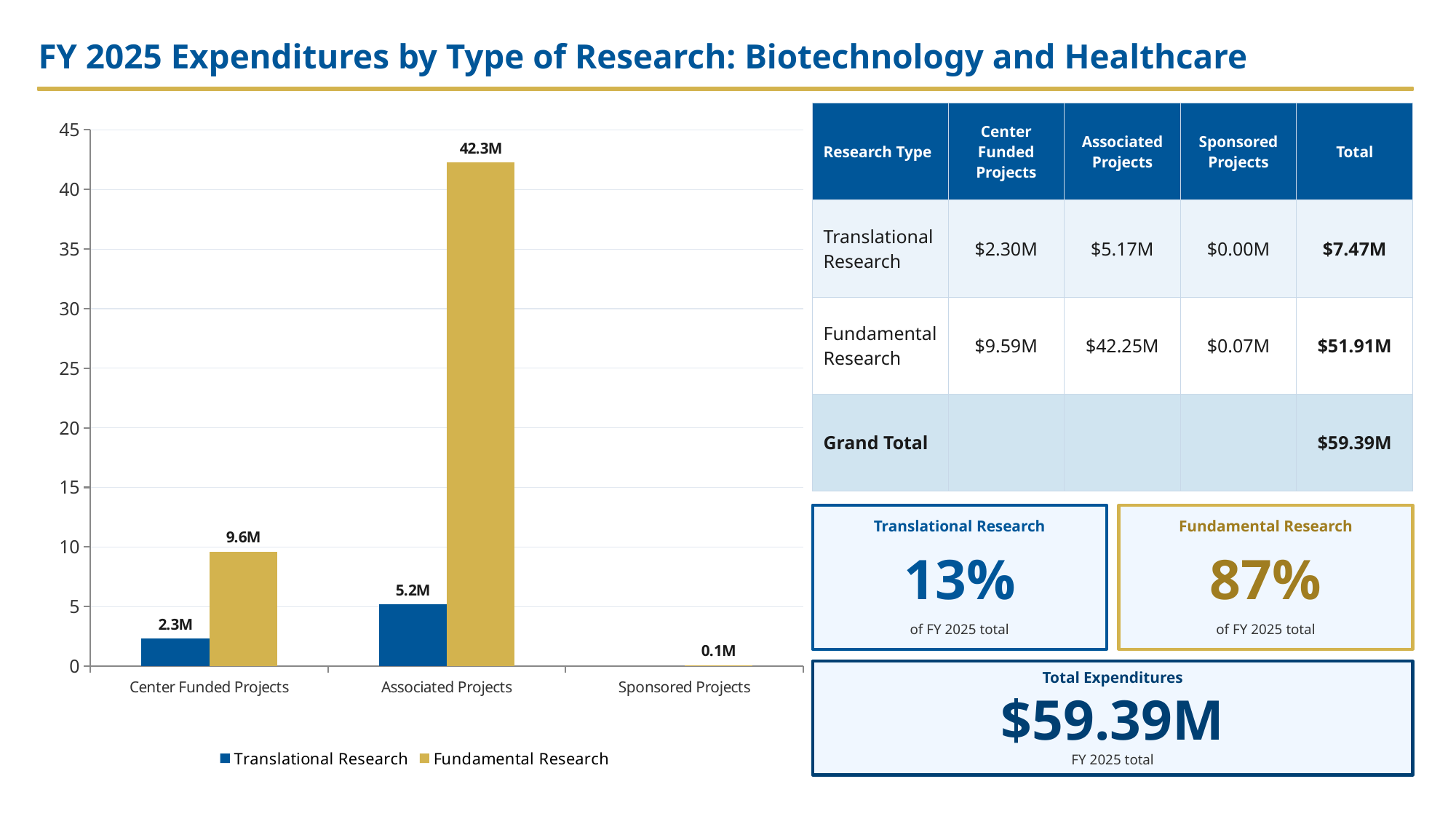
What kind of chart is shown? bar chart What is the value for Fundamental Research in Associated Projects? 42.3M Is the Fundamental Research value for Associated Projects greater or less than 40? greater How many series does the legend list? 2 What is the value for Translational Research in Center Funded Projects? 2.3M How many categories are shown on the x axis? 3 What is the value for Fundamental Research in Sponsored Projects? 0.1M Which is larger in Associated Projects: Translational Research or Fundamental Research? Fundamental Research Which category has the lowest Fundamental Research value? Sponsored Projects Which series is shown in gold? Fundamental Research Which category has the highest Fundamental Research value? Associated Projects What is the difference between Fundamental Research and Translational Research in Center Funded Projects? 7.3M